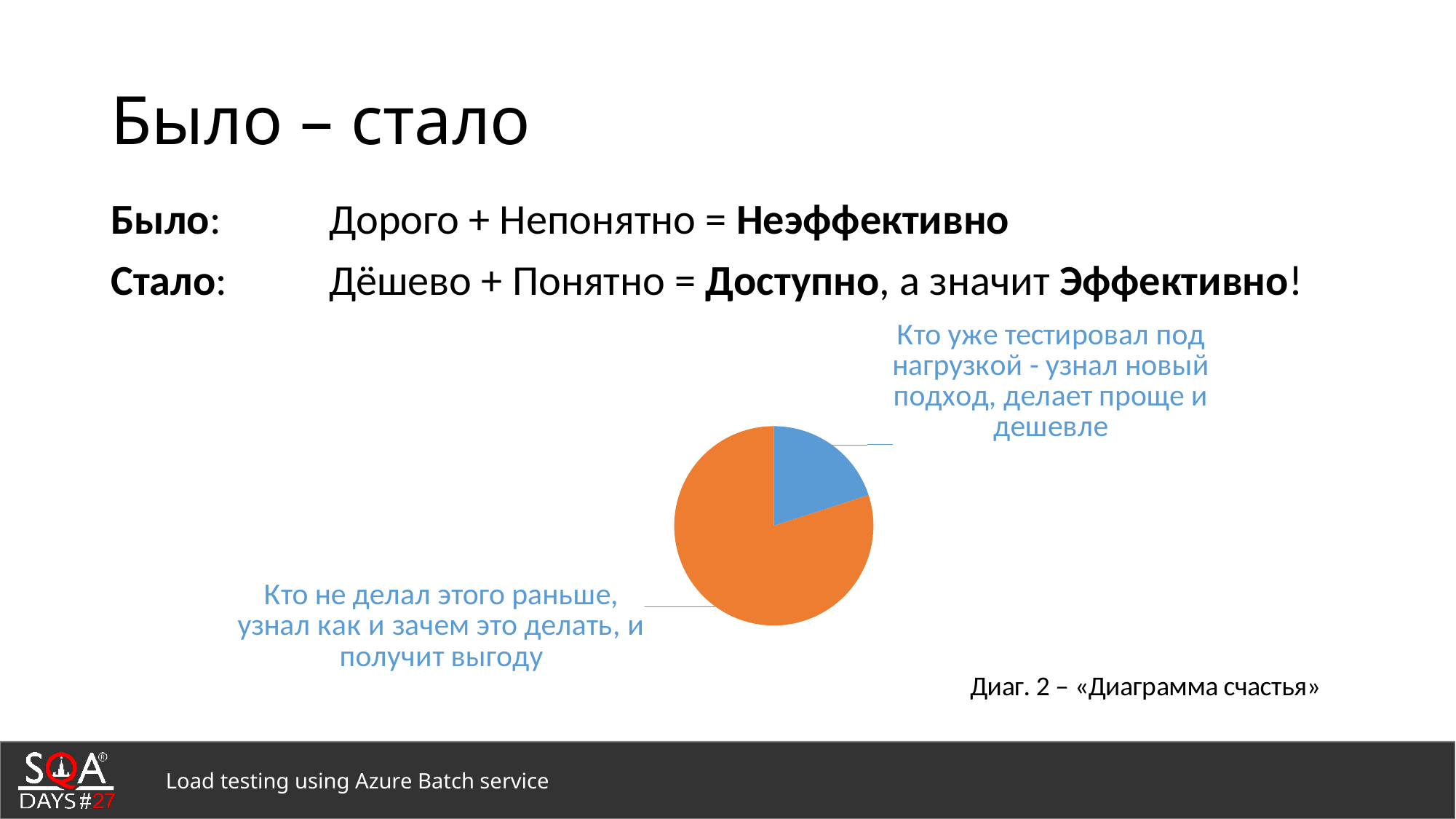
Which slice of the pie chart is the smallest? Кто уже тестировал под нагрузкой - узнал новый подход, делает проще и дешевле Which slice of the pie chart is the largest? Кто не делал этого раньше, узнал как и зачем это делать, и получит выгоду What colour is the slice labelled "Кто не делал этого раньше, узнал как и зачем это делать, и получит выгоду"? orange What kind of chart is shown on the slide? pie chart How many slices does the pie chart have? 2 Which slice is larger: "Кто уже тестировал под нагрузкой" or "Кто не делал этого раньше"? Кто не делал этого раньше What is the caption given for the pie chart on the slide? Диаг. 2 – «Диаграмма счастья»